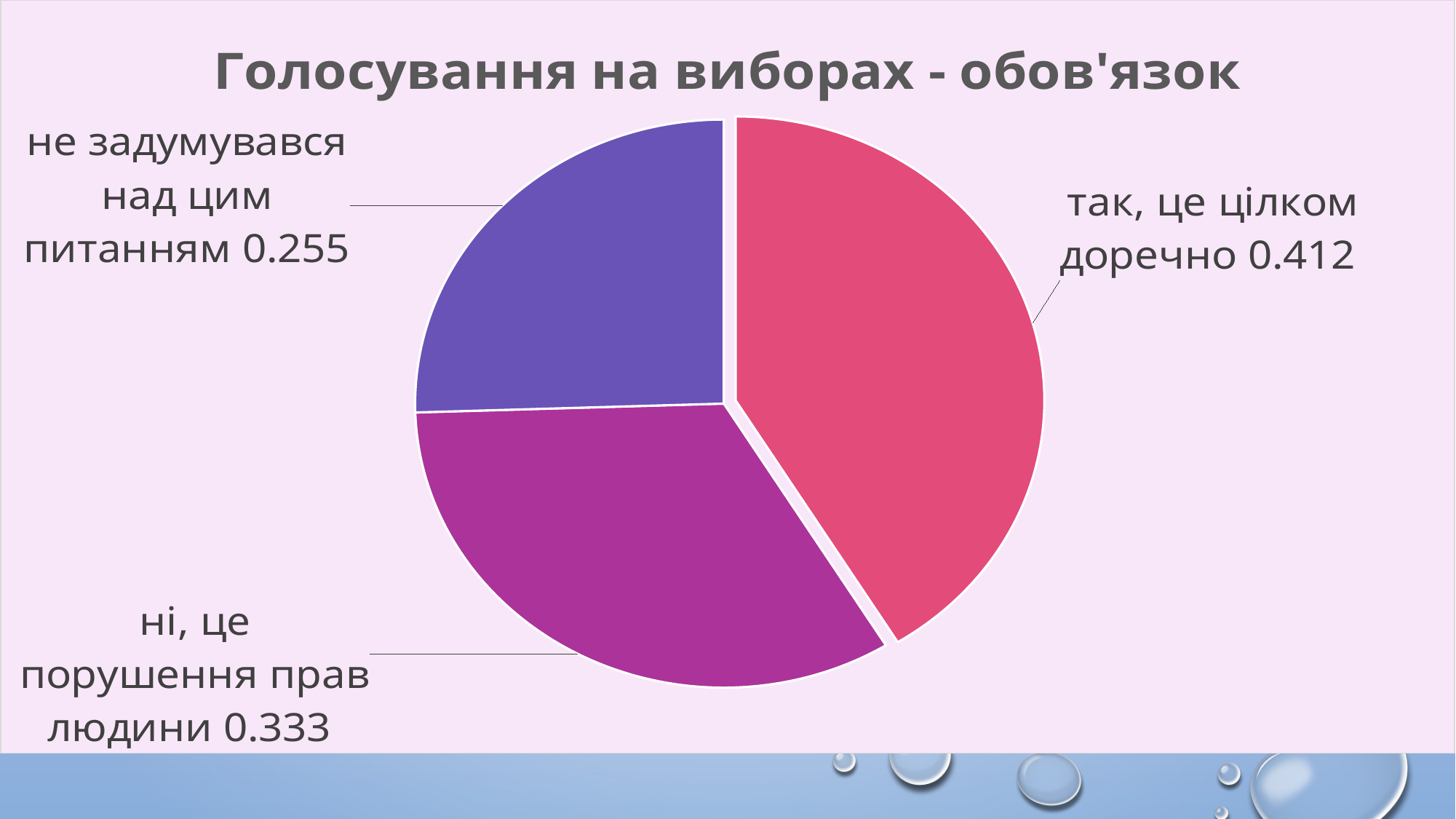
How many slices does the pie chart have? 3 Which slice has the largest value? так, це цілком доречно What is the difference between the values for 'так, це цілком доречно' and 'ні, це порушення прав людини'? 0.079 Which is larger: the value for 'ні, це порушення прав людини' or for 'не задумувався над цим питанням'? ні, це порушення прав людини What kind of chart is shown on the slide? pie chart What is the title of the chart? Голосування на виборах - обов'язок What value is shown for the slice 'так, це цілком доречно'? 0.412 What is the difference between the values for 'ні, це порушення прав людини' and 'не задумувався над цим питанням'? 0.078 What value is shown for the slice 'не задумувався над цим питанням'? 0.255 What value is shown for the slice 'ні, це порушення прав людини'? 0.333 Which slice has the smallest value? не задумувався над цим питанням What colour is the slice for 'так, це цілком доречно'? pink/red